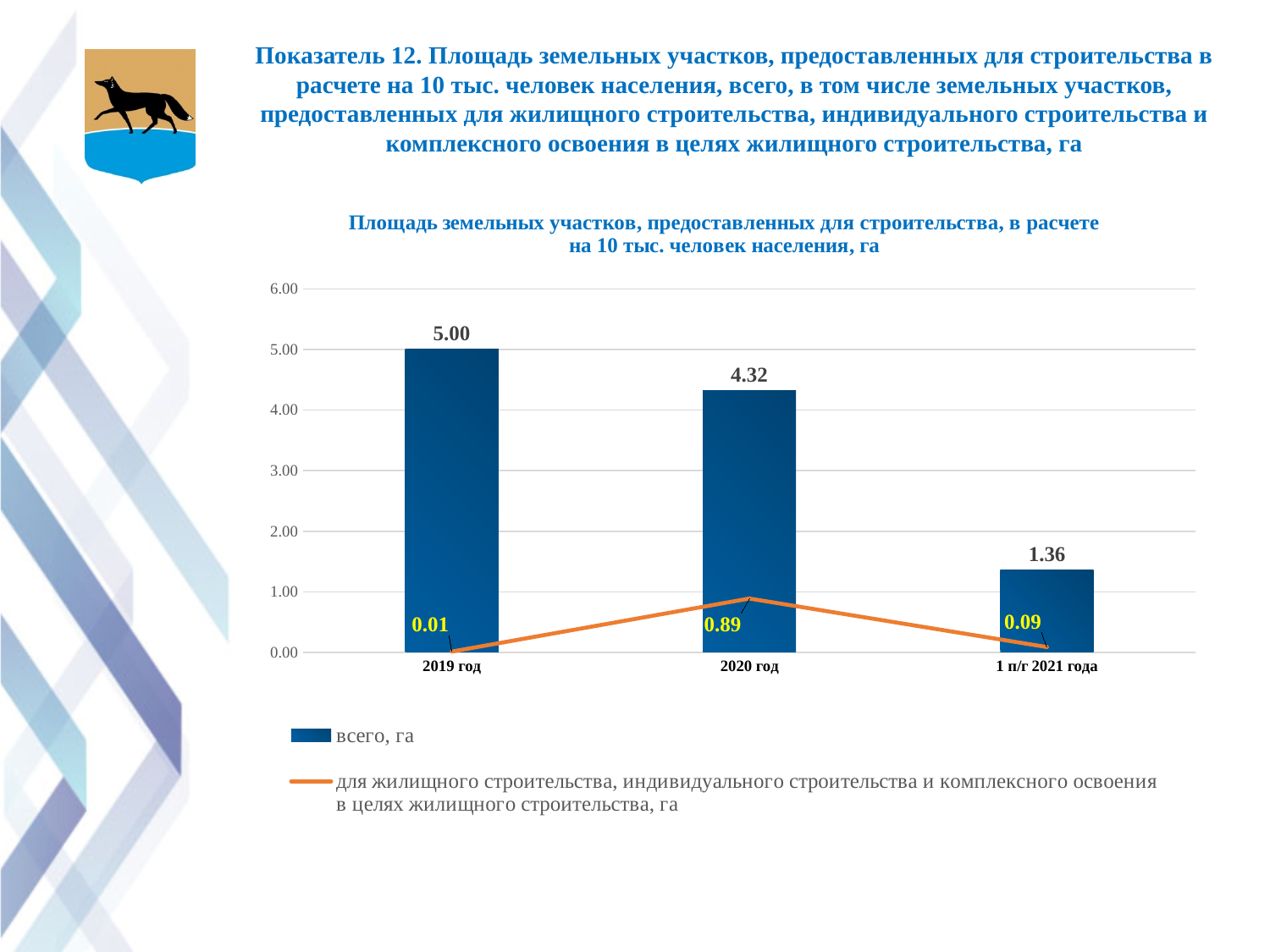
What is the difference between the 'всего, га' values for 2019 год and 2020 год? 0.68 What is the value of 'всего, га' for 2019 год? 5.00 What is the value of the line series (для жилищного строительства...) for 1 п/г 2021 года? 0.09 What is the value of the line series (для жилищного строительства...) for 2020 год? 0.89 What is the value of 'всего, га' for 2020 год? 4.32 How many periods are shown on the x axis? 3 Which is larger: the 'всего, га' value for 2020 год or for 1 п/г 2021 года? 2020 год What is the value of 'всего, га' for 1 п/г 2021 года? 1.36 Which period has the highest value for 'всего, га'? 2019 год Which period has the lowest value for the line series (для жилищного строительства...)? 2019 год How many series does the legend list? 2 Do the 'всего, га' values rise or fall from 2019 год to 1 п/г 2021 года? fall